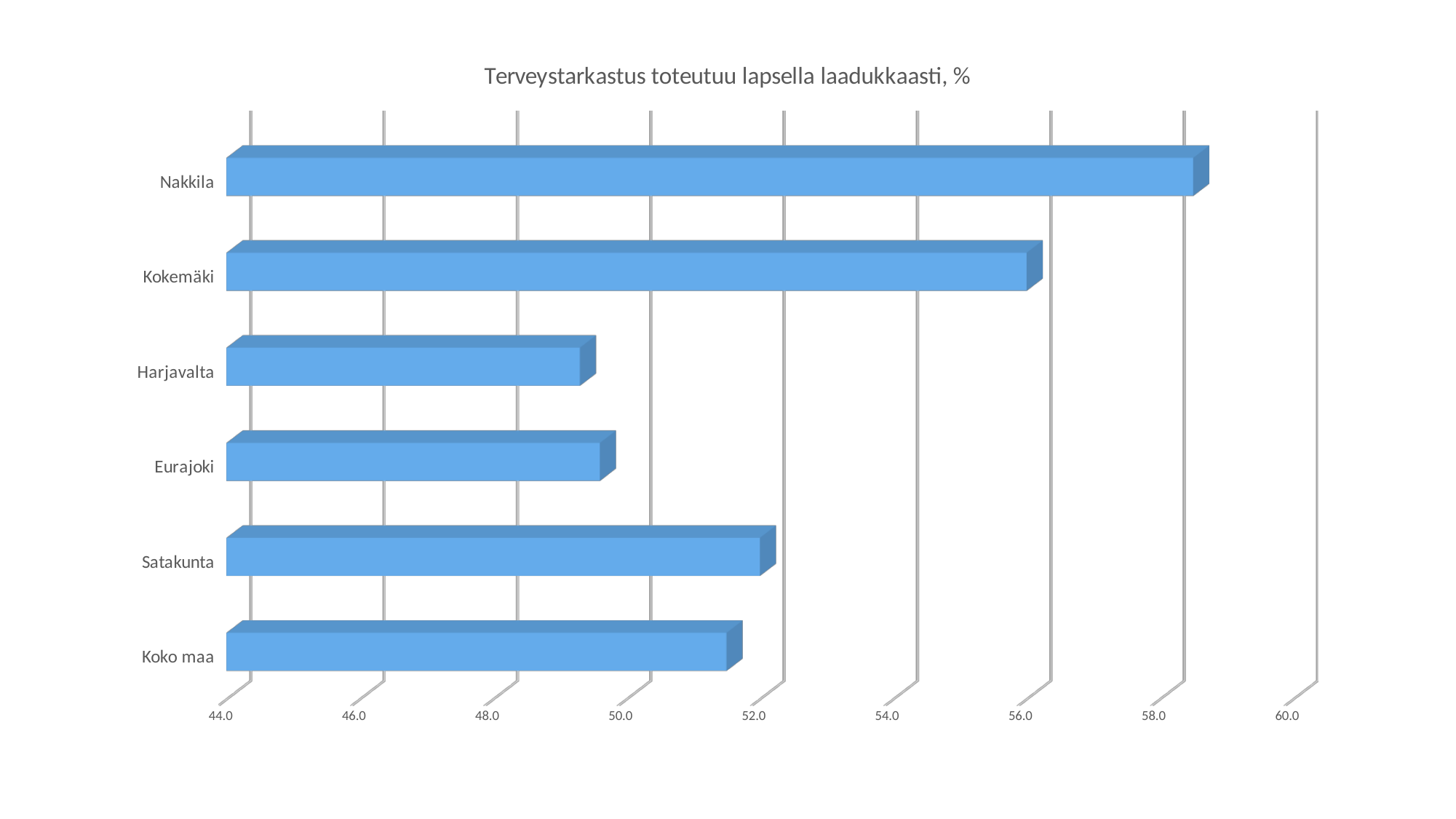
How many categories are shown in the chart? 6 Is the value for Kokemäki greater or less than 58.0? less Which has a larger value, Kokemäki or Satakunta? Kokemäki What is the title of the chart? Terveystarkastus toteutuu lapsella laadukkaasti, % Is the value for Kokemäki greater or less than 54.0? greater Is the value for Nakkila greater or less than 56.0? greater Which has a larger value, Nakkila or Kokemäki? Nakkila Which category has the highest value? Nakkila What kind of chart is shown on the slide? Bar chart